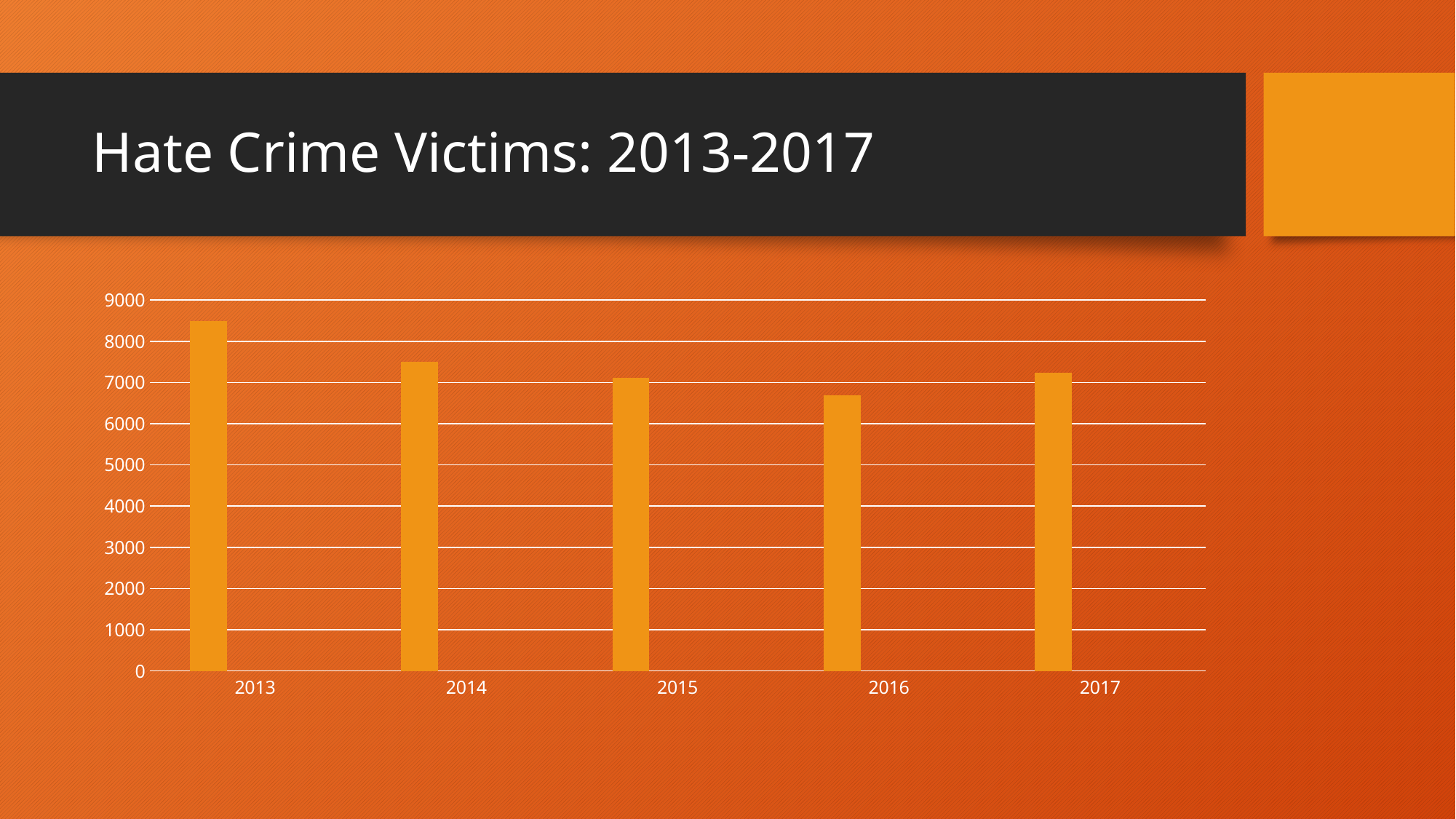
Is the value for 2013 greater or less than 8000? greater Is the value for 2016 greater or less than 7000? less What kind of chart is shown on the slide? bar chart Which year has the larger value, 2014 or 2015? 2014 How many years (categories) are plotted on the x axis? 5 Is the value for 2014 greater or less than 7000? greater Which year has the larger value, 2013 or 2016? 2013 Which year has the lowest number of hate crime victims? 2016 Do the values rise or fall from 2013 to 2016? fall What is the title of the slide containing the chart? Hate Crime Victims: 2013-2017 Which year has the highest number of hate crime victims? 2013